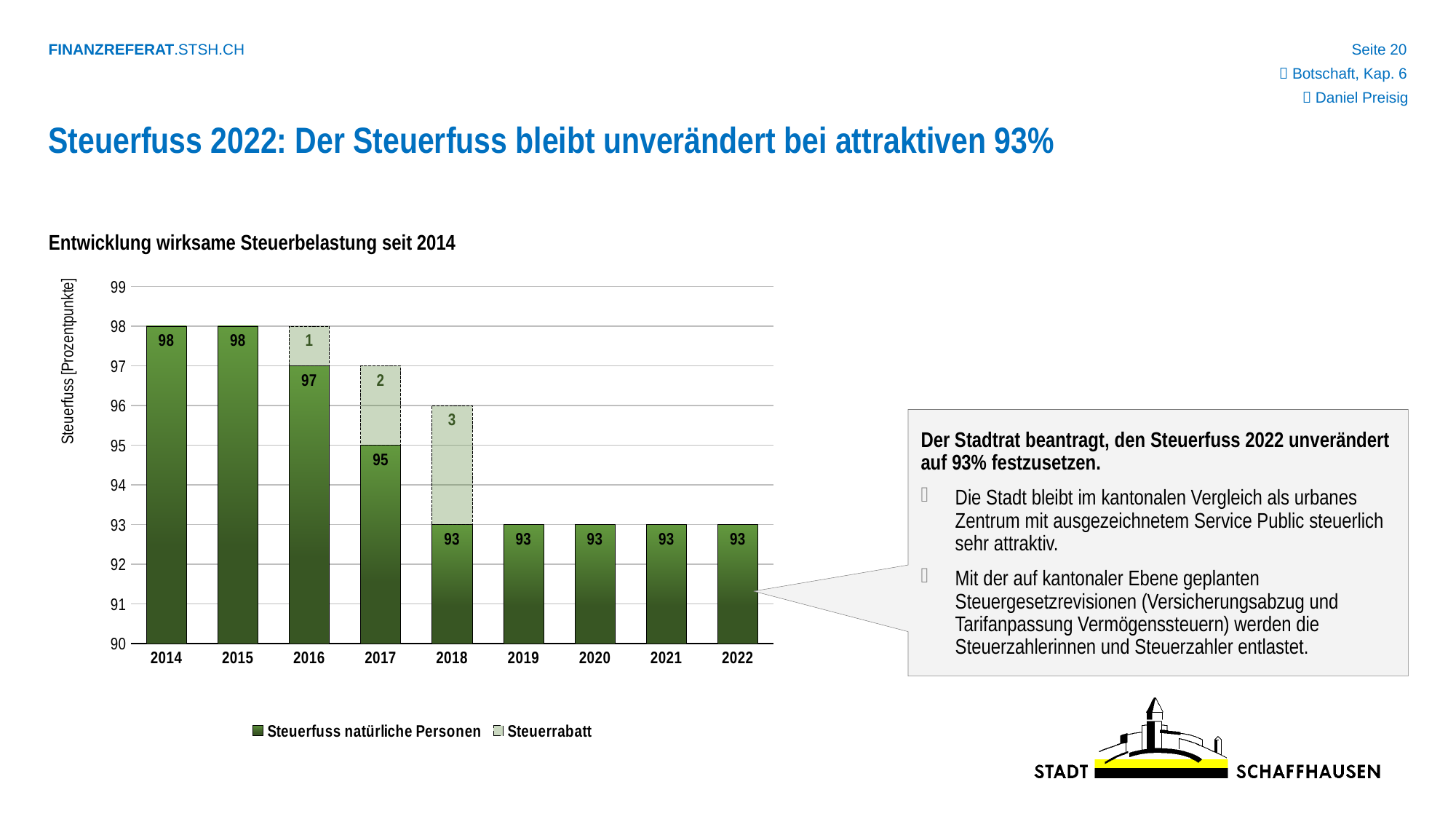
What is the value of Steuerfuss natürliche Personen for 2017? 95 How many years are shown on the x axis? 9 What is the total of the stacked bar for 2017? 97 What is the difference between the Steuerfuss natürliche Personen values for 2014 and 2022? 5 What is the Steuerrabatt value for 2018? 3 Which year has the lowest Steuerrabatt value among the years where it is shown? 2016 What is the value of Steuerfuss natürliche Personen for 2014? 98 Is the Steuerfuss natürliche Personen value for 2016 larger or smaller than for 2018? larger What is the Steuerrabatt value for 2016? 1 Does the Steuerfuss natürliche Personen value rise or fall from 2014 to 2022? fall How many series does the legend list? 2 What is the total of the stacked bar for 2018? 96